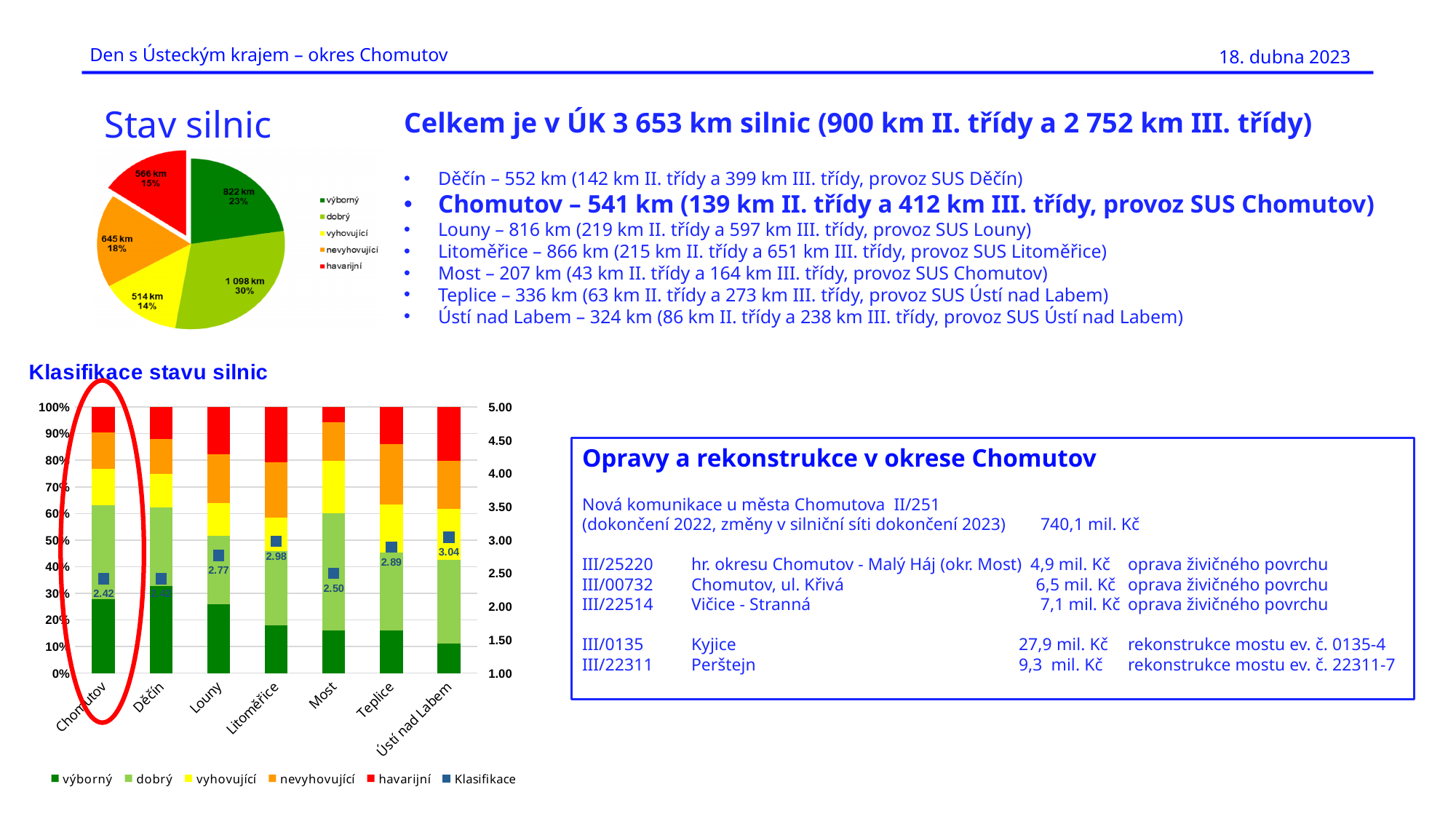
In the chart 'Klasifikace stavu silnic', which district has the highest Klasifikace value? Ústí nad Labem In the chart 'Klasifikace stavu silnic', how many districts are shown on the x axis? 7 In the chart 'Klasifikace stavu silnic', is the 'výborný' share for Ústí nad Labem greater or less than 20%? less In the pie chart 'Stav silnic', how many categories does the legend list? 5 In the pie chart 'Stav silnic', how many km are in the 'dobrý' category? 1 098 km In the pie chart 'Stav silnic', which category has the smallest slice? vyhovující In the chart 'Klasifikace stavu silnic', what is the Klasifikace value for Chomutov? 2.42 In the chart 'Klasifikace stavu silnic', which has a higher Klasifikace value, Louny or Litoměřice? Litoměřice In the pie chart 'Stav silnic', which category has the largest slice? dobrý In the chart 'Klasifikace stavu silnic', what is the difference between the Klasifikace values of Ústí nad Labem and Chomutov? 0.62 In the pie chart 'Stav silnic', what share of the pie does 'havarijní' represent? 15% In the pie chart 'Stav silnic', what is the difference in km between 'výborný' and 'havarijní'? 256 km